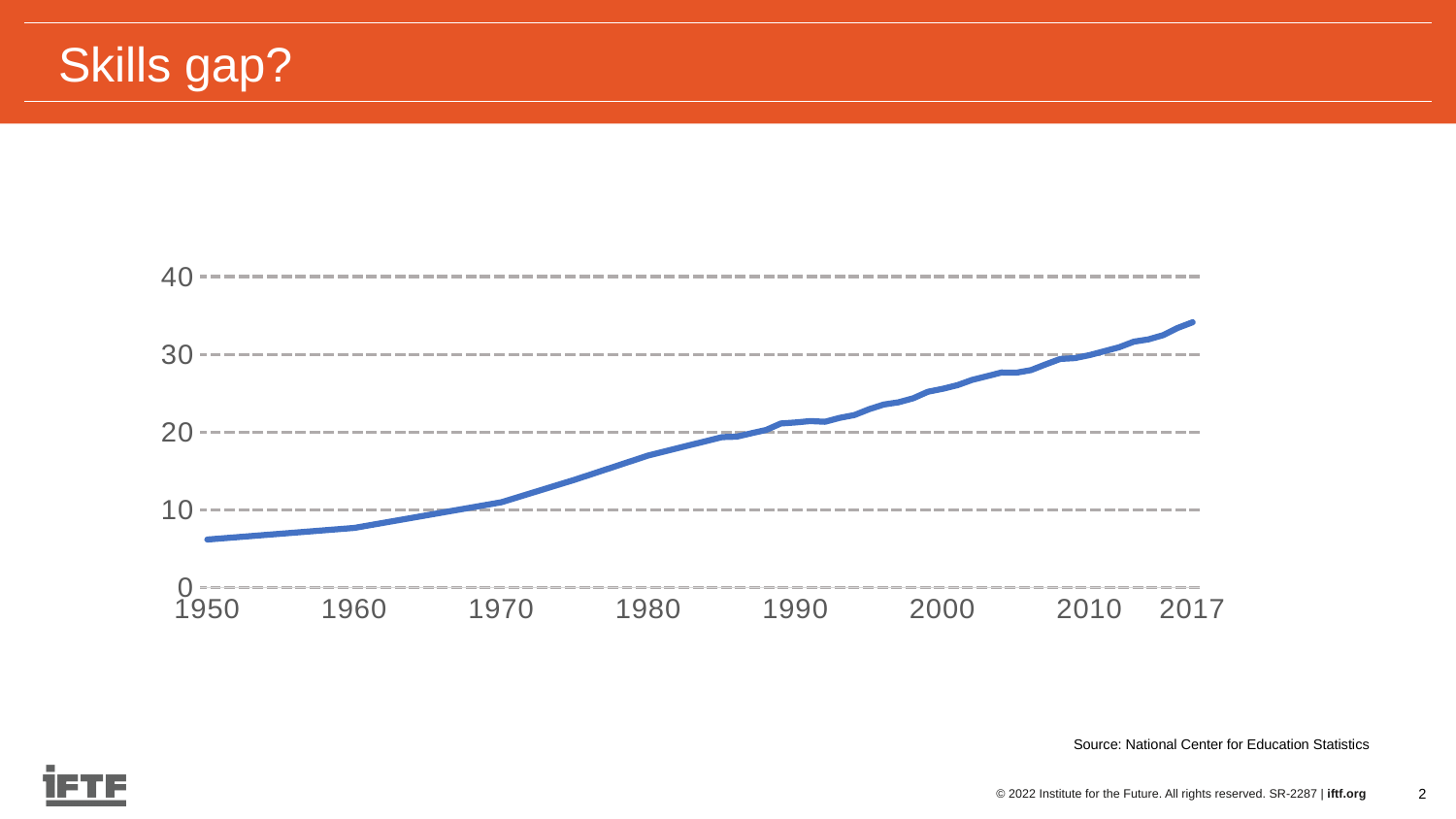
Is the value for 2000 greater or less than 20? greater Is the value for 1980 greater or less than 20? less Is the value for 2017 greater or less than 30? greater Which year shown on the x axis has the highest value? 2017 What kind of chart is shown on the slide? line chart Do the values rise or fall from 1950 to 2017? rise What source is cited for the chart? National Center for Education Statistics Which year shown on the x axis has the lowest value? 1950 Which is larger, the value for 2010 or the value for 1960? 2010 What is the highest value labelled on the y axis? 40